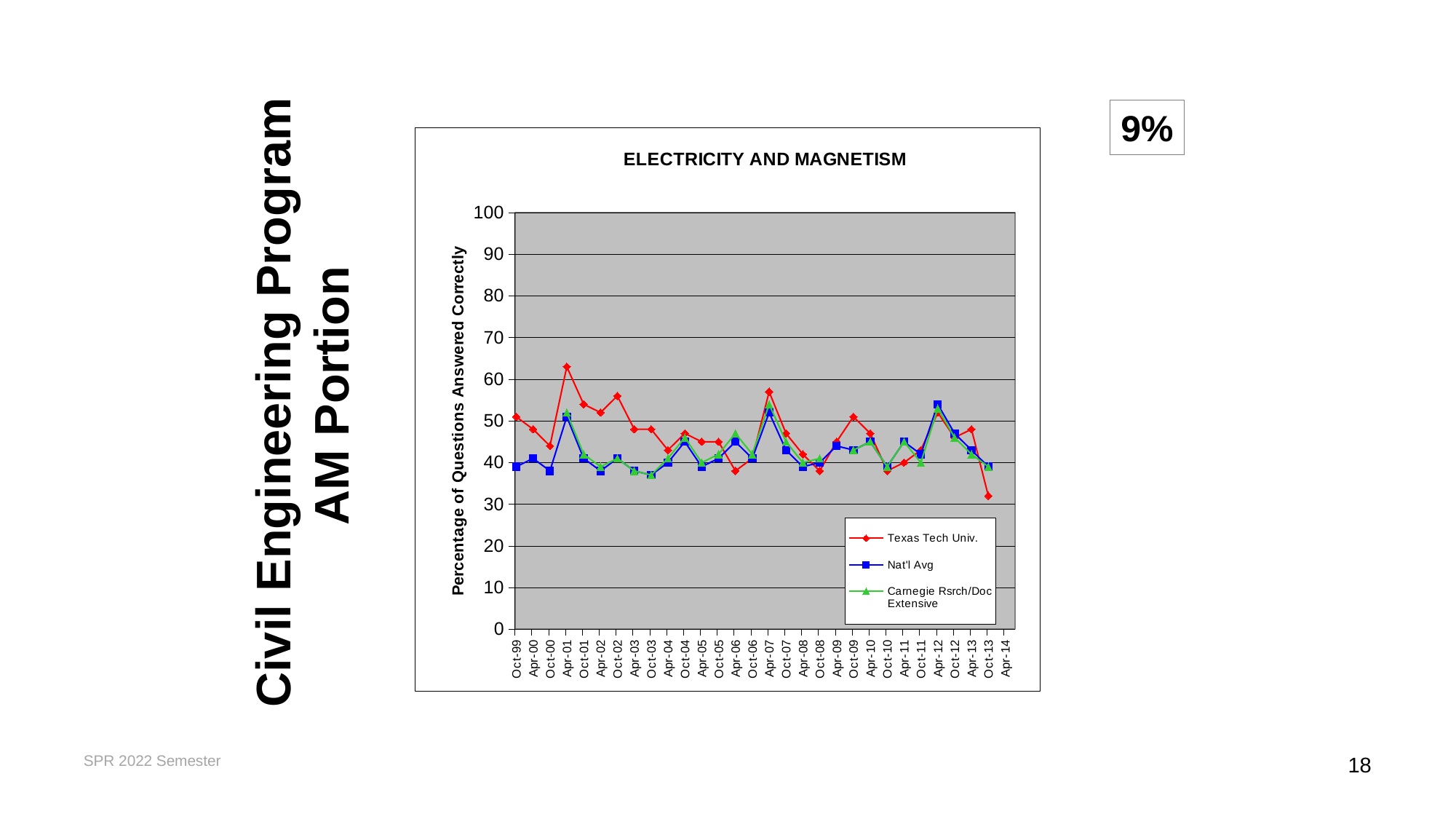
At which date does the Texas Tech Univ. series reach its highest value? Apr-01 Does the Texas Tech Univ. series rise or fall from Apr-13 to Oct-13? Fall What is the title of the chart? ELECTRICITY AND MAGNETISM What type of chart is shown on the slide? Line chart What is the label of the vertical axis? Percentage of Questions Answered Correctly At which date does the Texas Tech Univ. series reach its lowest value? Oct-13 Is the Texas Tech Univ. value at Oct-02 greater or less than 50? greater Is the Texas Tech Univ. value at Apr-01 greater or less than 60? greater At Oct-13, which is higher: Texas Tech Univ. or Nat'l Avg? Nat'l Avg How many series does the legend list? 3 Is the Texas Tech Univ. value at Oct-13 greater or less than 40? less At Apr-01, which is higher: Texas Tech Univ. or Nat'l Avg? Texas Tech Univ.